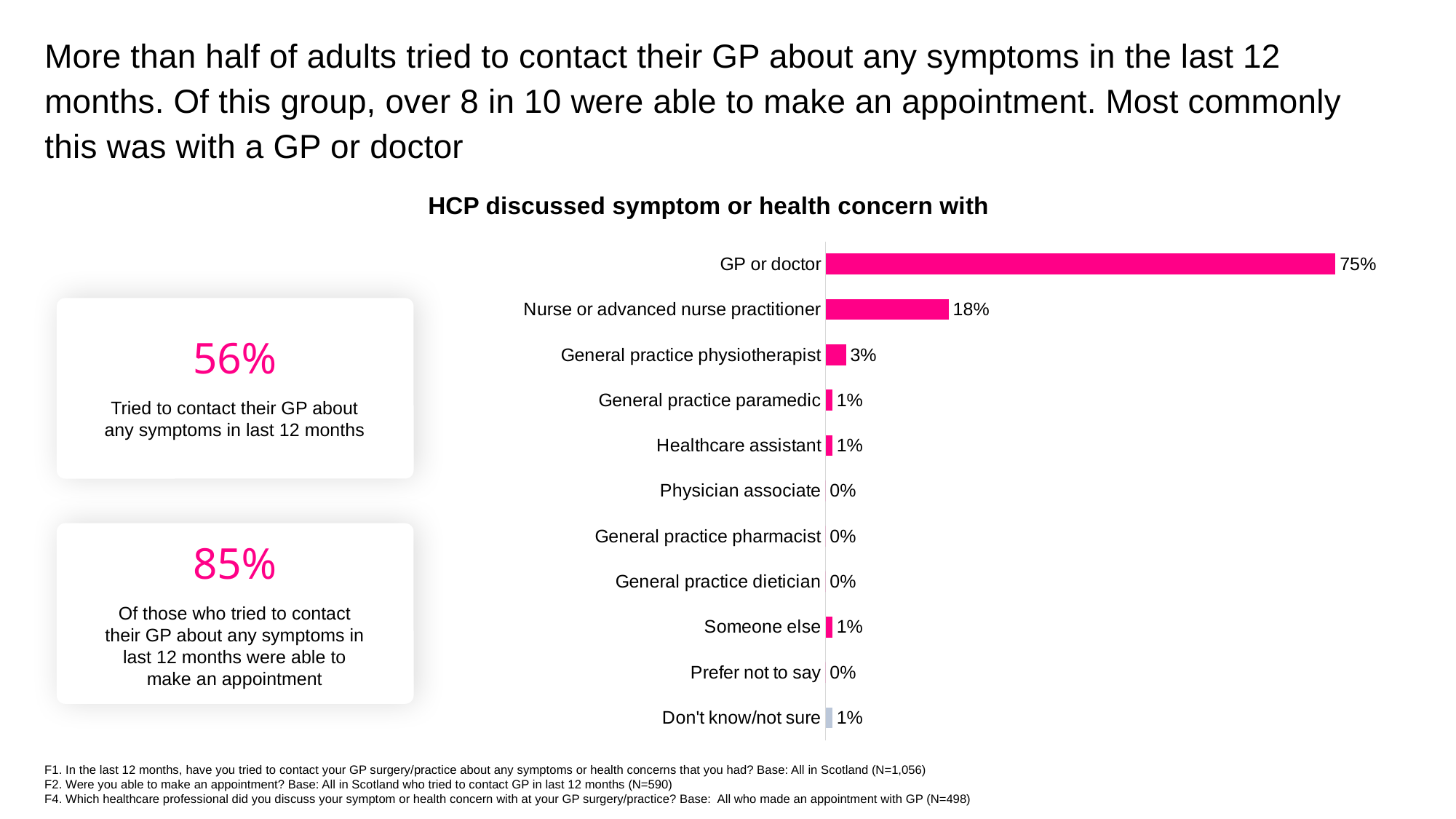
What kind of chart is shown on the slide? Bar chart What is the value for Nurse or advanced nurse practitioner? 18% What is the value for Don't know/not sure? 1% What is the difference between the values for Nurse or advanced nurse practitioner and General practice physiotherapist? 15 percentage points What is the difference between the values for GP or doctor and Nurse or advanced nurse practitioner? 57 percentage points Which category has the highest value in the chart? GP or doctor What is the title of the chart? HCP discussed symptom or health concern with What is the value for General practice physiotherapist? 3% How many categories are shown in the chart? 11 Which is larger, the value for General practice physiotherapist or the value for General practice paramedic? General practice physiotherapist How many categories in the chart have a value of 0%? 4 What is the value for GP or doctor in the 'HCP discussed symptom or health concern with' chart? 75%